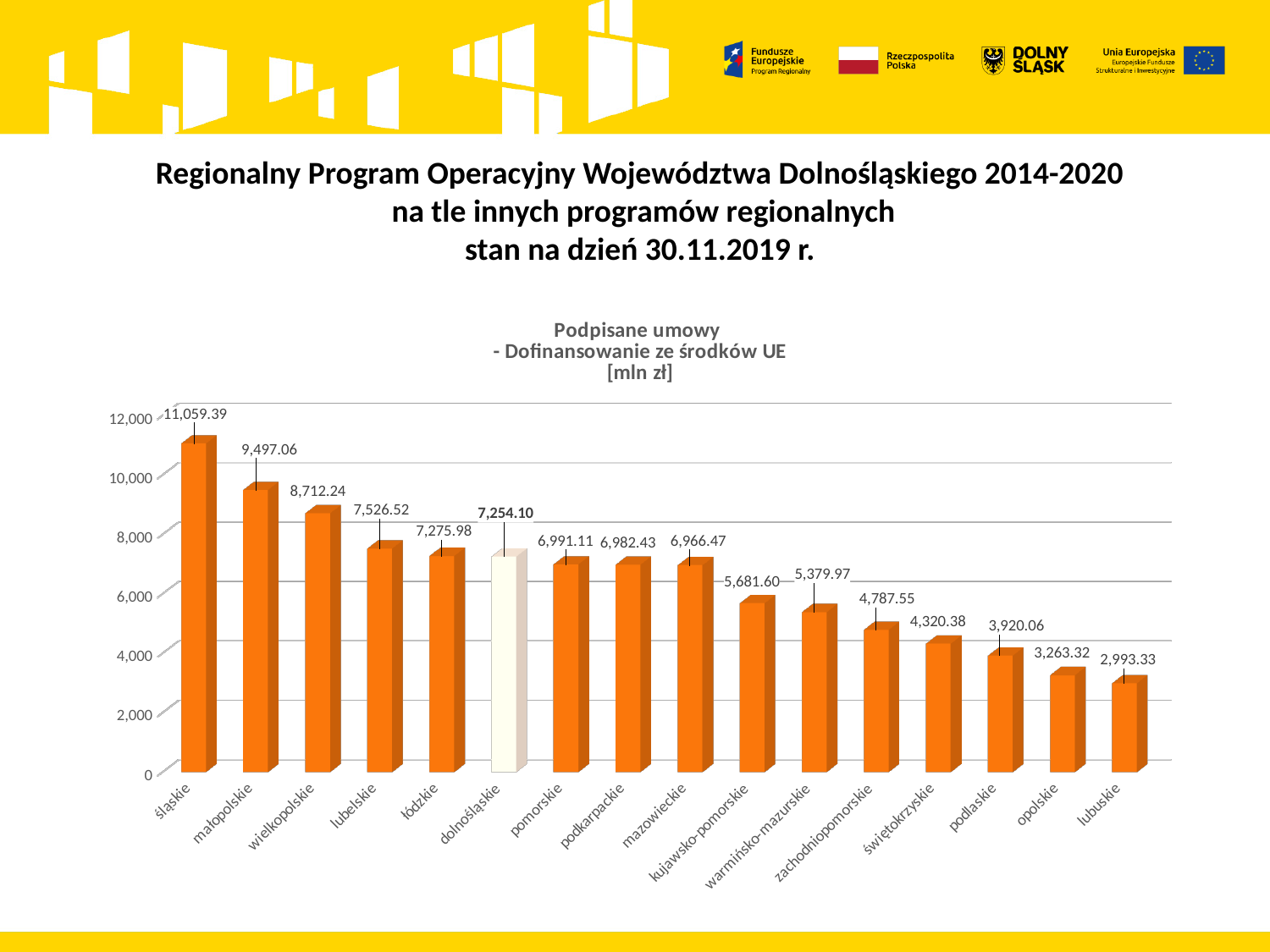
Which region has the lowest value? lubuskie Which region has the highest value? śląskie What is the difference between the values for małopolskie and wielkopolskie? 784.82 What is the value for lubuskie? 2,993.33 What is the value for dolnośląskie? 7,254.10 What is the value for kujawsko-pomorskie? 5,681.60 Which is larger, the value for lubelskie or the value for zachodniopomorskie? lubelskie What is the difference between the values for śląskie and lubuskie? 8,066.06 How many regions are shown on the chart? 16 Do the values rise or fall from left to right along the x axis? fall What is the value for śląskie? 11,059.39 What kind of chart is shown on the slide? bar chart